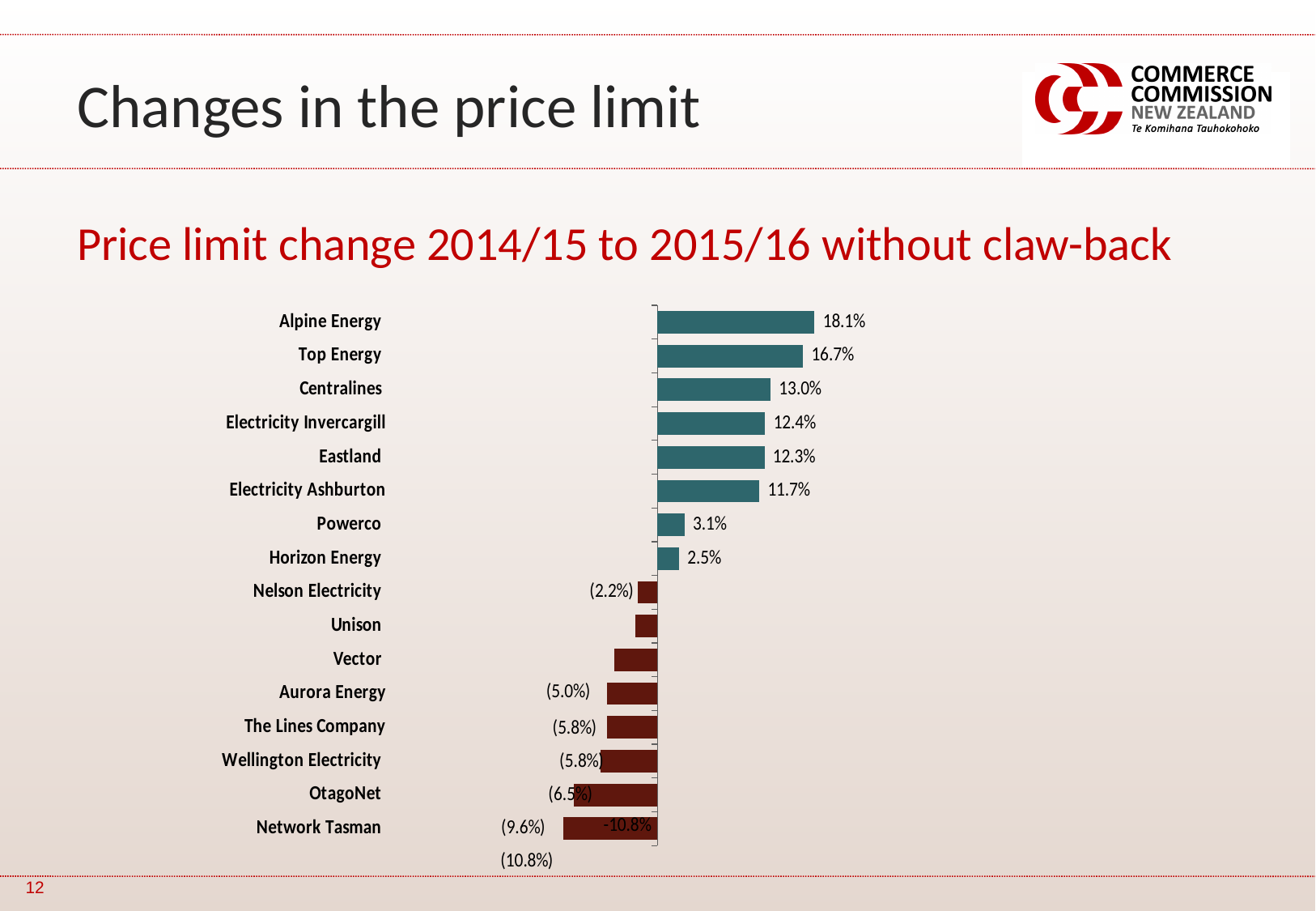
What kind of chart is shown on the slide? Bar chart Which company has the highest price limit change? Alpine Energy What is the price limit change shown for Alpine Energy? 18.1% How many companies have a positive price limit change? 8 What is the difference between the values for Powerco and Horizon Energy? 0.6% What is the value for Powerco? 3.1% What is the difference between the values for Alpine Energy and Top Energy? 1.4% What value is shown for Centralines? 13.0% Which company has the lowest (most negative) price limit change? Network Tasman How many companies are listed in the chart? 16 What value is shown for Horizon Energy? 2.5% Which is larger, the value for Centralines or for Electricity Ashburton? Centralines